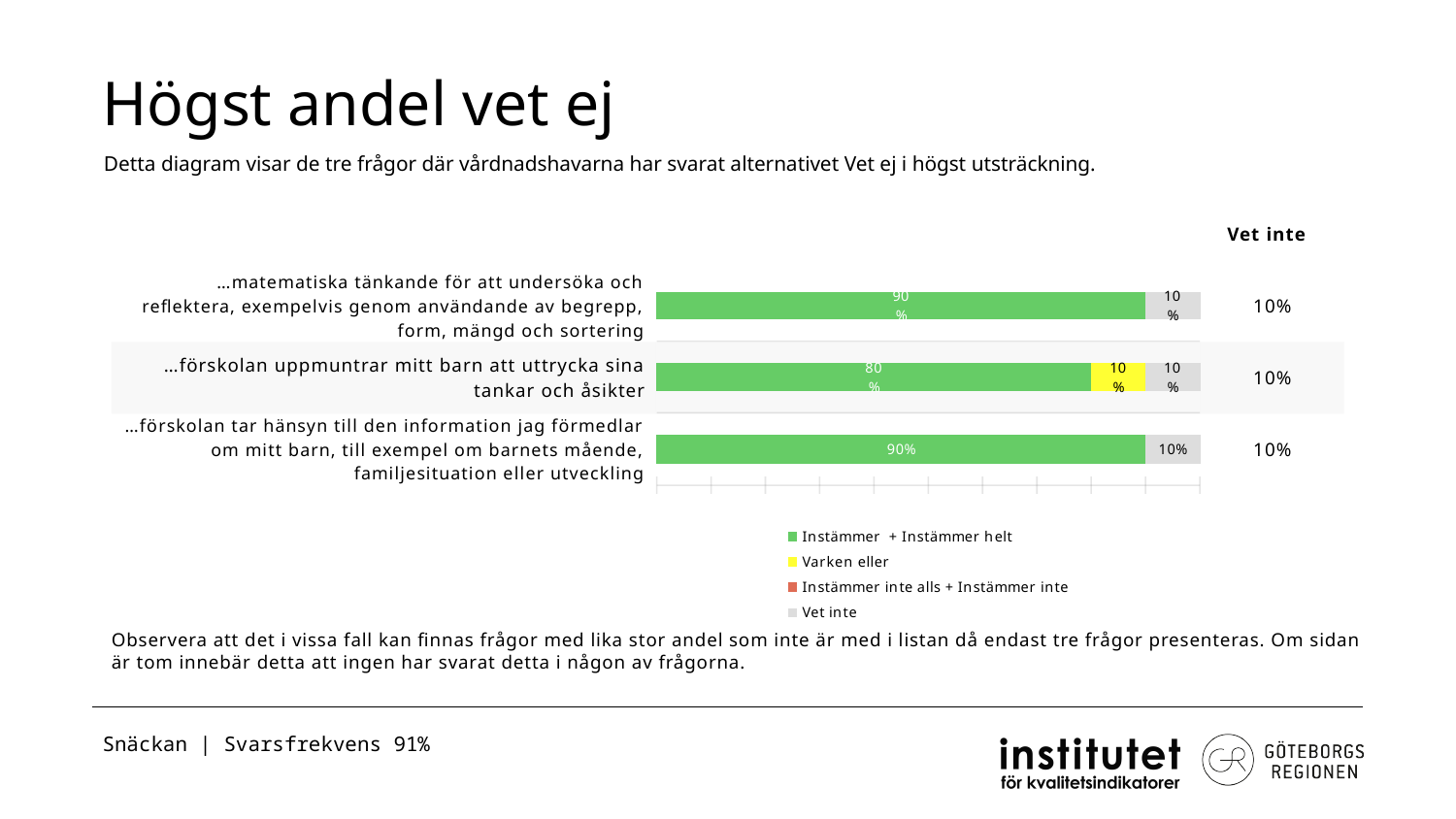
What is the 'Instämmer + Instämmer helt' value for '…förskolan tar hänsyn till den information jag förmedlar om mitt barn, till exempel om barnets mående, familjesituation eller utveckling'? 90% What is the difference between the 'Instämmer + Instämmer helt' value for '…matematiska tänkande för att undersöka och reflektera…' and for '…förskolan uppmuntrar mitt barn att uttrycka sina tankar och åsikter'? 10% Which category has the lowest 'Instämmer + Instämmer helt' value? …förskolan uppmuntrar mitt barn att uttrycka sina tankar och åsikter Which is larger: the 'Instämmer + Instämmer helt' value for '…förskolan tar hänsyn till den information jag förmedlar…' or for '…förskolan uppmuntrar mitt barn att uttrycka sina tankar och åsikter'? …förskolan tar hänsyn till den information jag förmedlar… How many categories (questions) are plotted in the chart? 3 What is the title of the slide containing the chart? Högst andel vet ej What is the 'Instämmer + Instämmer helt' value for '…förskolan uppmuntrar mitt barn att uttrycka sina tankar och åsikter'? 80% What type of chart is shown on the slide? stacked bar chart What is the 'Vet inte' value shown for '…matematiska tänkande för att undersöka och reflektera, exempelvis genom användande av begrepp, form, mängd och sortering'? 10% How many series does the legend list? 4 What is the 'Varken eller' value for '…förskolan uppmuntrar mitt barn att uttrycka sina tankar och åsikter'? 10% What is the total of the stacked bar for '…förskolan uppmuntrar mitt barn att uttrycka sina tankar och åsikter'? 100%